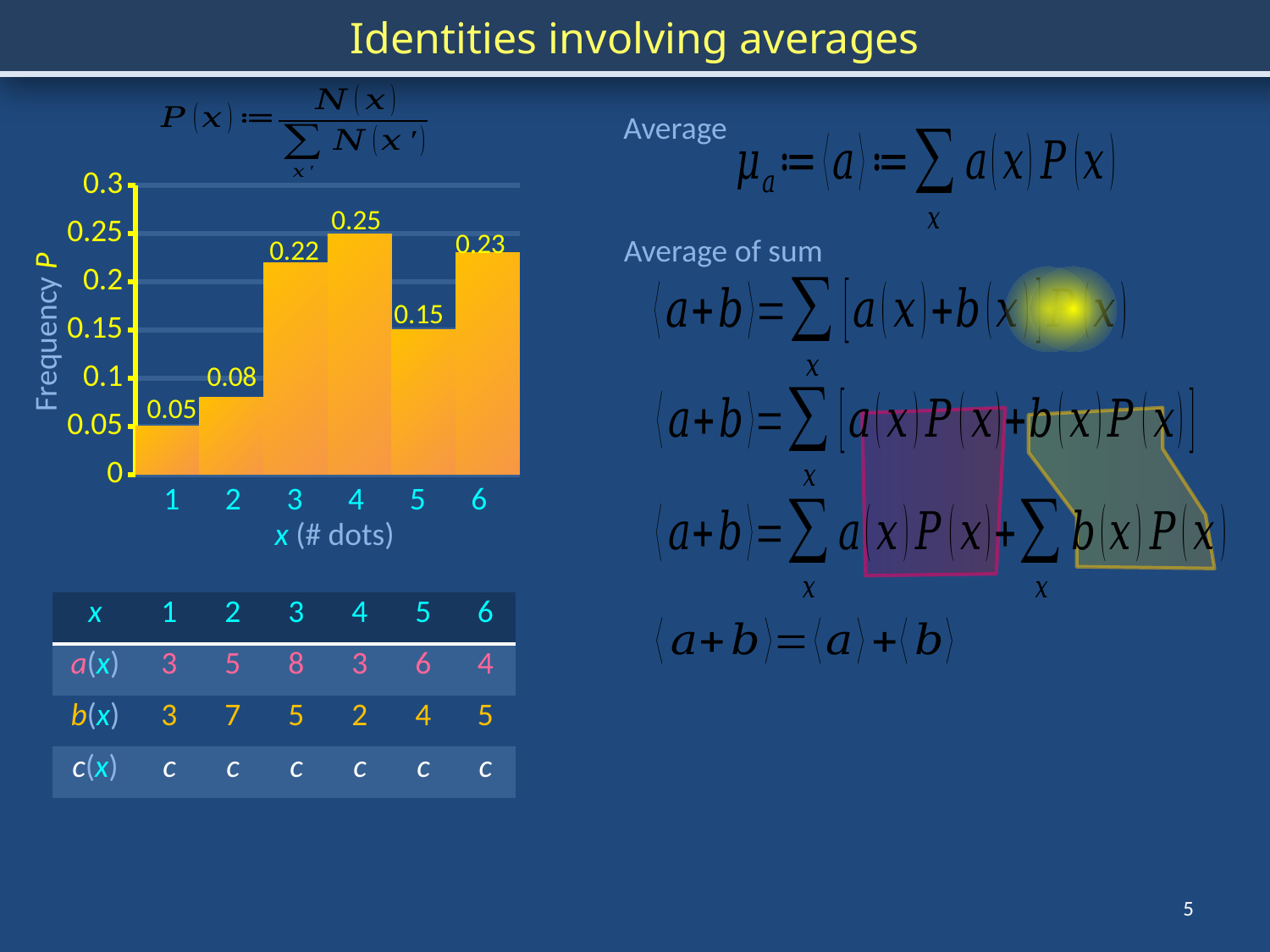
What kind of chart is shown on the slide? bar chart What is the frequency P for x = 6? 0.23 What is the label of the y axis of the chart? Frequency P What is the label of the x axis of the chart? x (# dots) What is the difference between the frequency for x = 3 and the frequency for x = 2? 0.14 What is the frequency P for x = 1? 0.05 Which value of x has the highest frequency P? 4 Which value of x has the lowest frequency P? 1 Is the frequency for x = 3 greater or less than 0.2? greater What is the frequency P for x = 4? 0.25 Which has a larger frequency P, x = 5 or x = 6? 6 How many values of x are plotted in the chart? 6